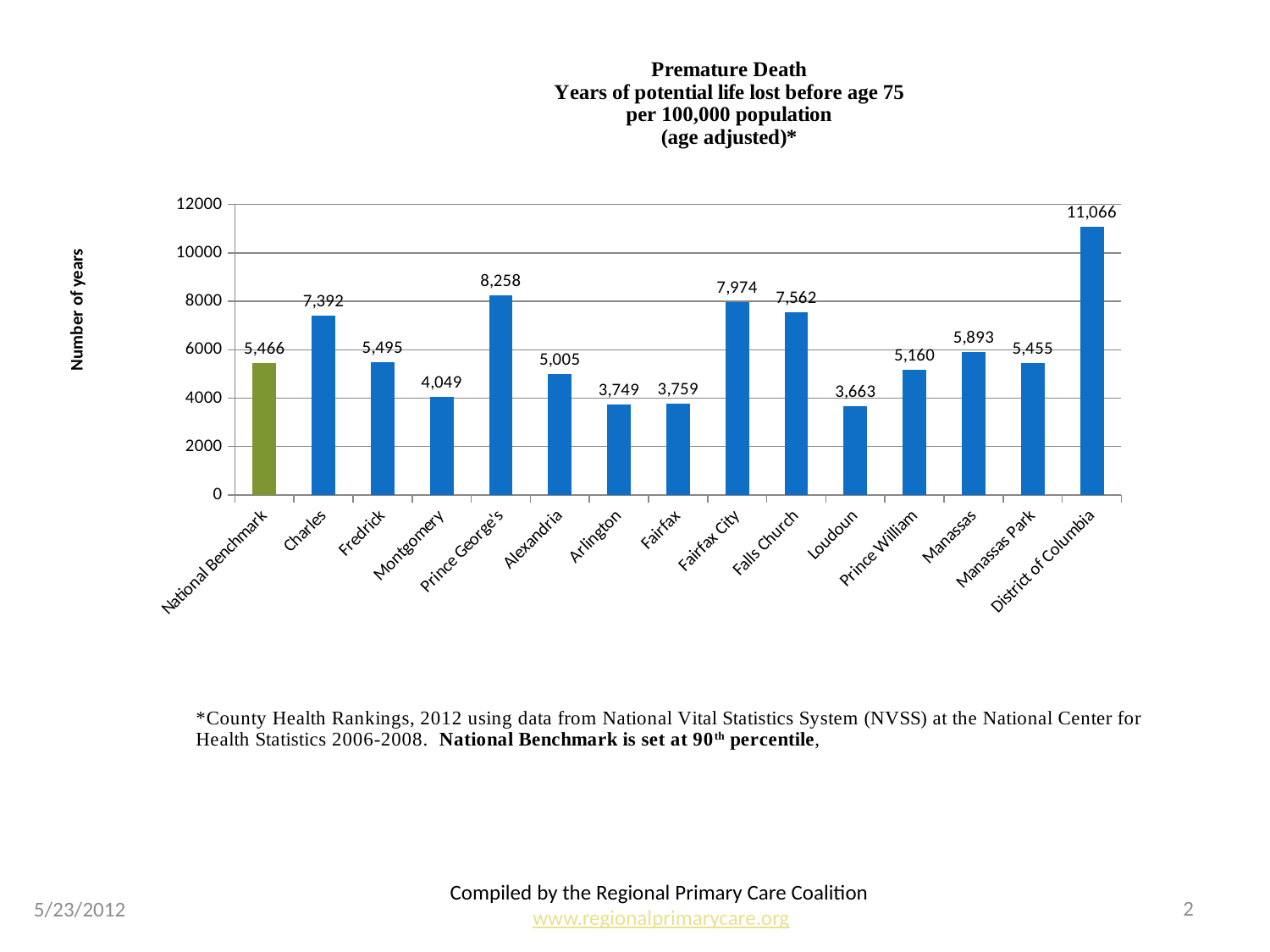
Is the value for Loudoun greater or less than 4000? less What kind of chart is shown on the slide? bar chart Which category has the lowest value? Loudoun Which category has the highest value? District of Columbia What is the value for Prince George's? 8,258 What is the value for the National Benchmark? 5,466 What is the difference between the values for District of Columbia and the National Benchmark? 5,600 Which is larger, the value for Fairfax City or the value for Falls Church? Fairfax City What is the difference between the values for Charles and Fredrick? 1,897 How many categories are shown on the x axis? 15 What is the label on the vertical axis? Number of years What is the value for District of Columbia? 11,066